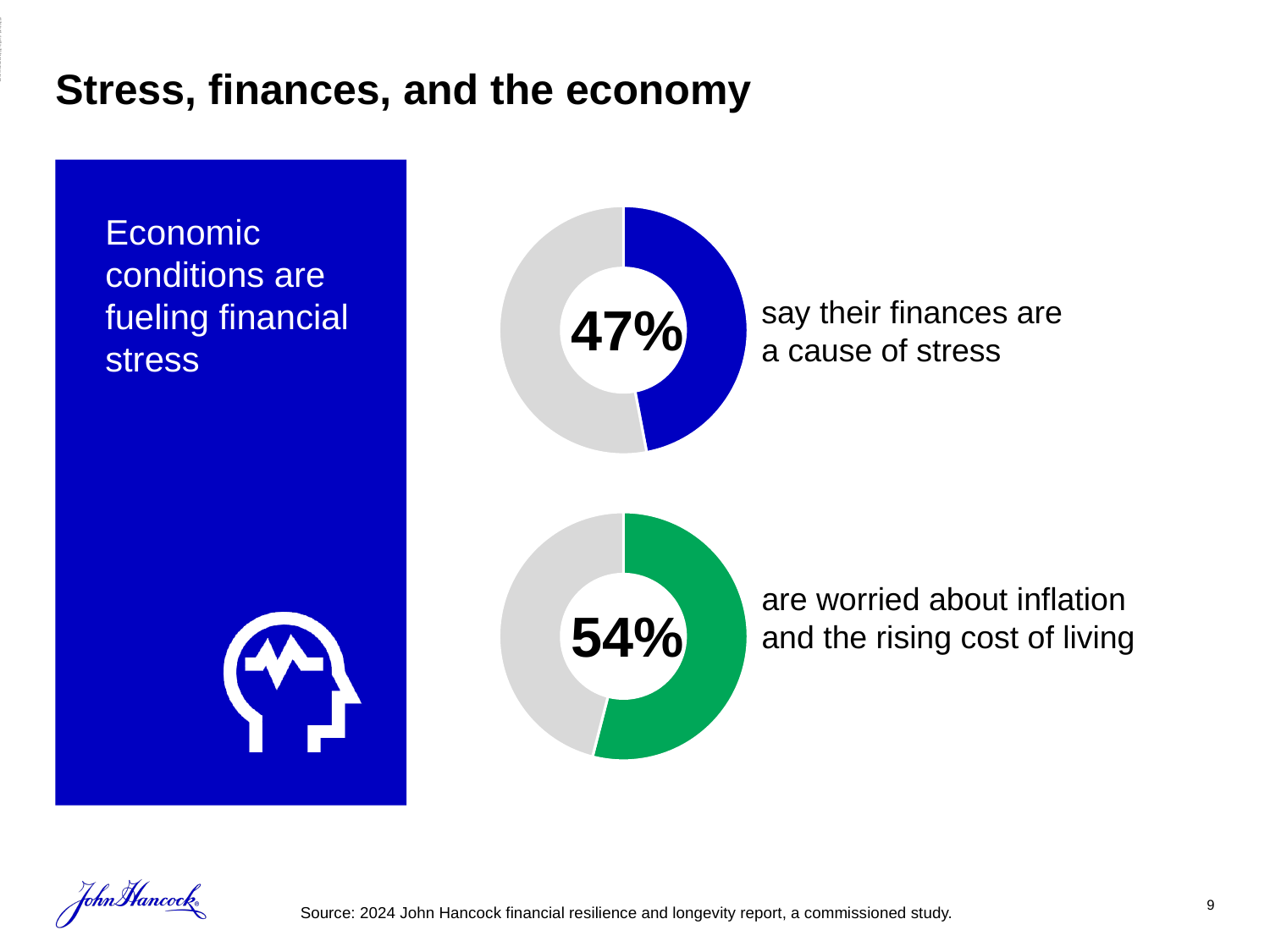
On the top chart, what percentage say their finances are a cause of stress? 47% Which is larger: the share who say their finances are a cause of stress (top chart) or the share worried about inflation and the rising cost of living (bottom chart)? Worried about inflation and the rising cost of living (54%) Is the value shown on the top chart greater or less than 50%? less What is the difference in percentage points between the bottom chart's 54% and the top chart's 47%? 7 percentage points What colour is the highlighted segment of the top chart showing 47%? Blue What kind of chart is used to show the 47% figure on the top of the slide? Donut chart What colour is the highlighted segment of the bottom chart showing 54%? Green On the bottom chart, what percentage are worried about inflation and the rising cost of living? 54% On the top chart, what share of the donut is the grey (remaining) portion? 53% Is the value shown on the bottom chart greater or less than 50%? greater How many donut charts are shown on the slide? 2 On the bottom chart, what share of the donut is the grey (remaining) portion? 46%